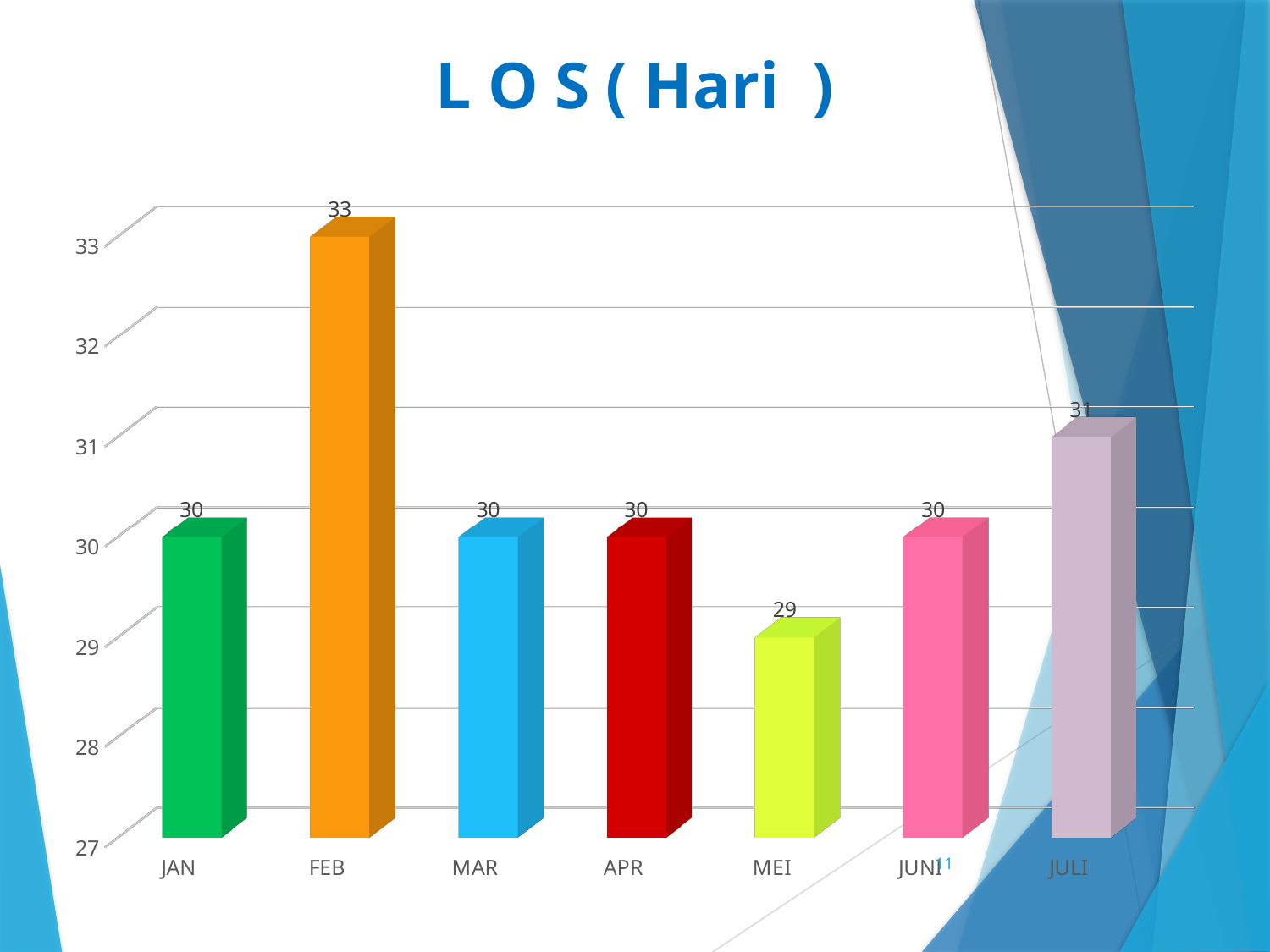
What is the value for MEI? 29 How many months are shown on the x axis? 7 What is the value for JULI? 31 Which month has the highest value? FEB What is the value for FEB? 33 What is the difference between the values for FEB and MEI? 4 Which month has the lowest value? MEI What kind of chart is shown on the slide? bar chart What is the difference between the values for JULI and JUNI? 1 What is the title of the chart? L O S ( Hari ) Which is larger, the value for JULI or the value for APR? JULI What is the value for JAN? 30